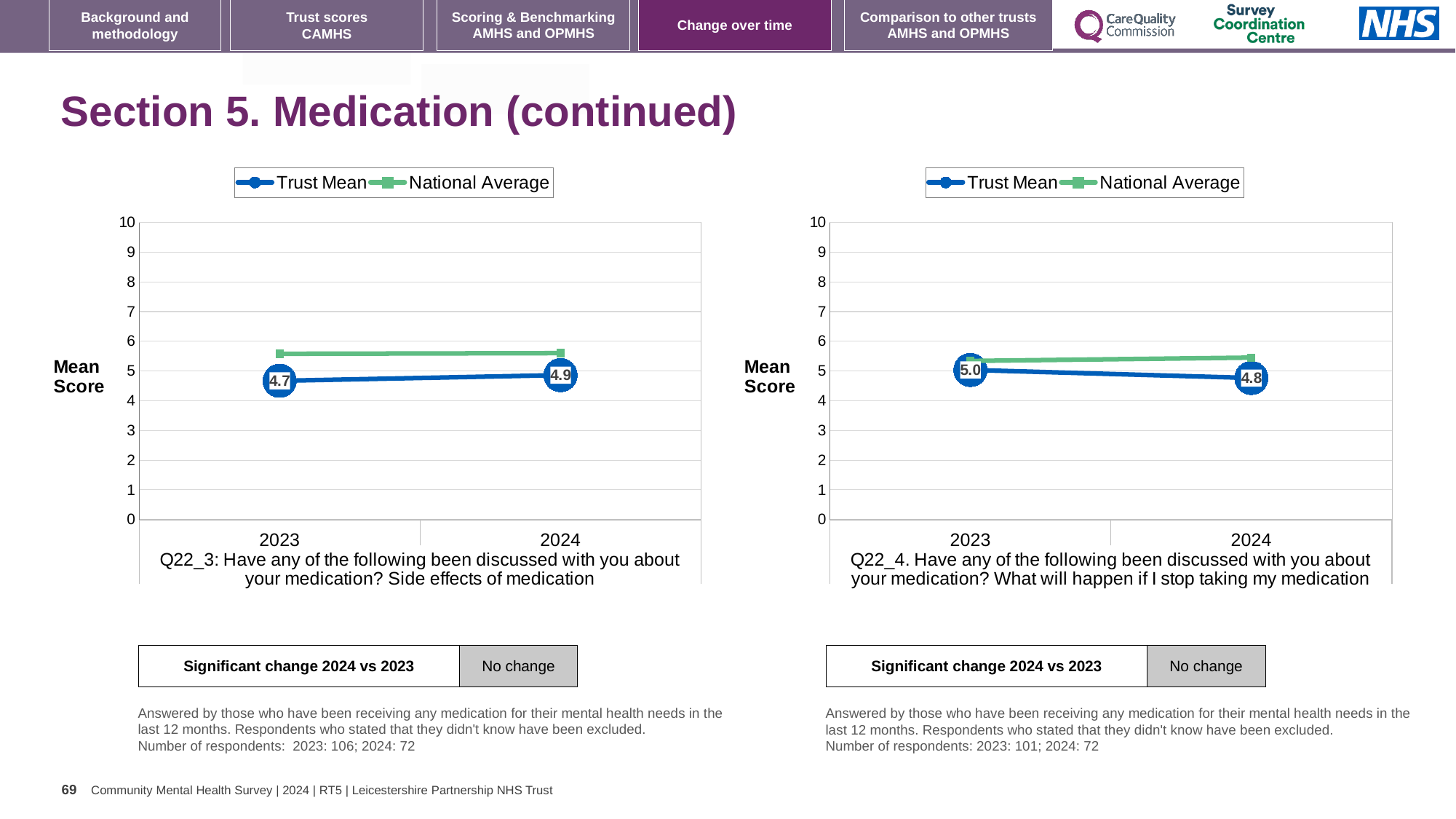
In the right chart (Q22_4), what is the Trust Mean score for 2023? 5.0 How many years are plotted on the x axis of the left chart (Q22_3)? 2 In the left chart (Q22_3), which is higher in 2023, the Trust Mean or the National Average? National Average In the left chart (Q22_3), what is the Trust Mean score for 2024? 4.9 In the left chart (Q22_3), by how much did the Trust Mean change from 2023 to 2024? 0.2 In the right chart (Q22_4), does the Trust Mean rise or fall from 2023 to 2024? fall In the left chart (Q22_3), what is the Trust Mean score for 2023? 4.7 In the right chart (Q22_4), what is the Trust Mean score for 2024? 4.8 In the left chart (Q22_3), does the Trust Mean rise or fall from 2023 to 2024? rise What kind of chart is the right chart (Q22_4)? line chart In the left chart (Q22_3), is the National Average for 2024 greater or less than 5? greater How many series does the legend of the right chart (Q22_4) list? 2